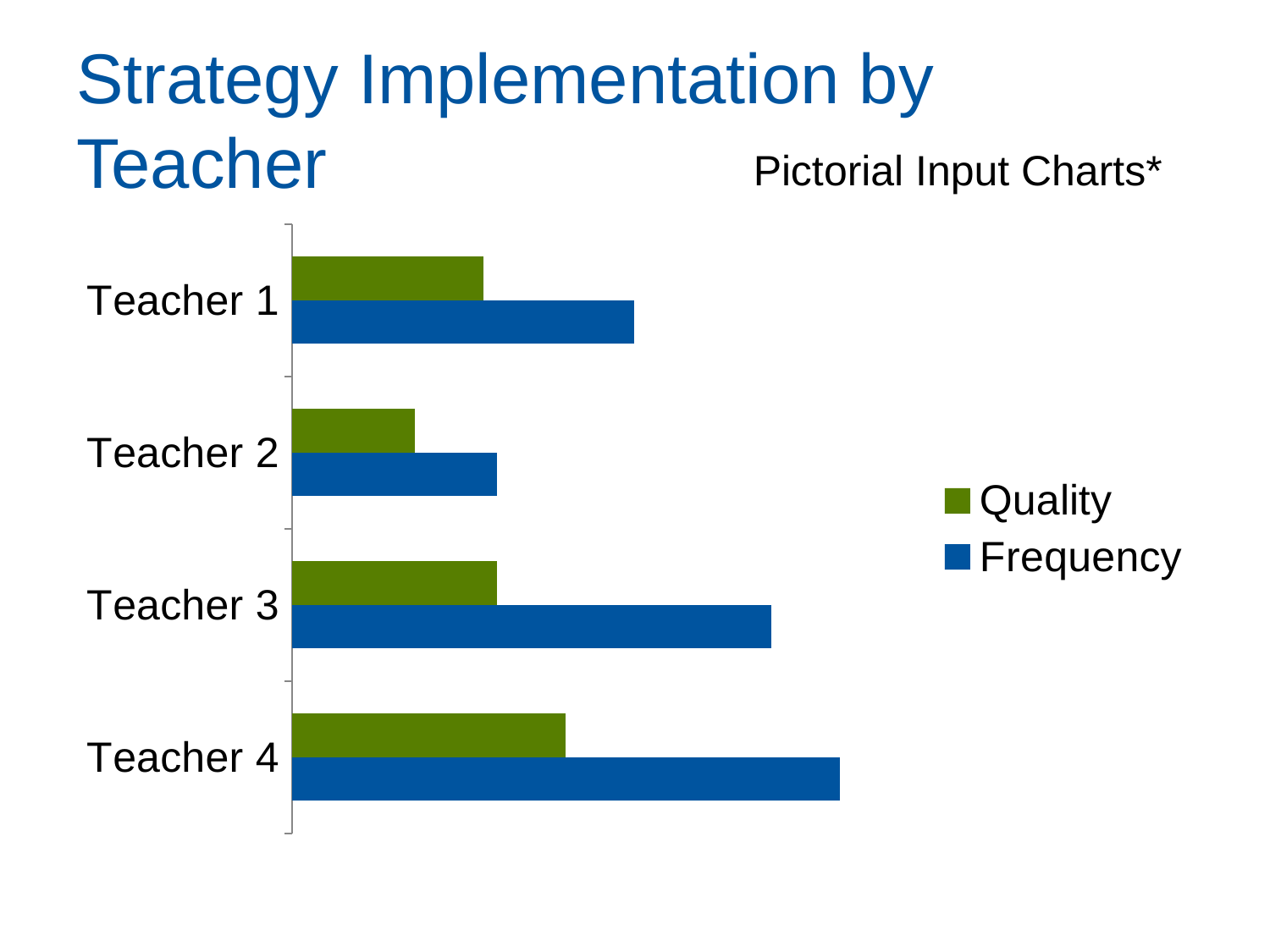
Is the Quality value for Teacher 4 larger or smaller than the Quality value for Teacher 2? larger Which teacher has the lowest Quality value? Teacher 2 Which teacher has the lowest Frequency value? Teacher 2 How many teachers are shown on the chart? 4 How many series does the legend list? 2 For Teacher 4, which series has the larger value, Quality or Frequency? Frequency Which teacher has the highest Frequency value? Teacher 4 What kind of chart is shown on the slide? bar chart Is the Frequency value for Teacher 3 larger or smaller than the Frequency value for Teacher 1? larger Which colour represents the Frequency series in the legend? blue Which teacher has the highest Quality value? Teacher 4